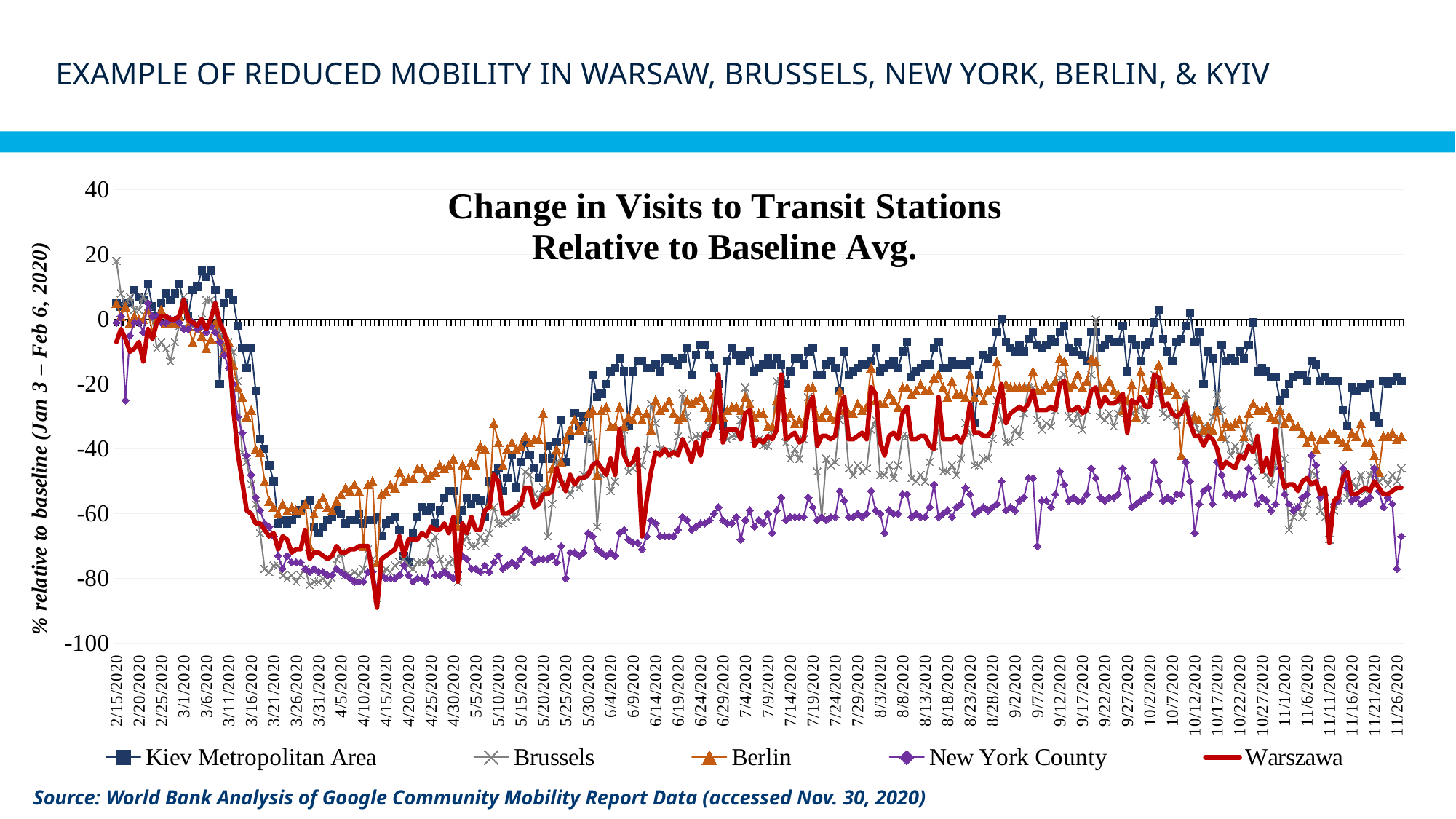
Is the value for New York County on 4/10/2020 greater or less than -60? less What kind of chart is shown on the slide? line chart On 11/26/2020, which is higher: Kiev Metropolitan Area or New York County? Kiev Metropolitan Area Is the value for Warszawa on 4/10/2020 greater or less than -60? less What is the label on the vertical axis of the chart? % relative to baseline (Jan 3 – Feb 6, 2020) How many series does the legend list? 5 Which series has the lowest value around 7/4/2020? New York County Between 3/11/2020 and 3/21/2020, do the values for Warszawa rise or fall? fall Between 4/15/2020 and 6/19/2020, do the values for Berlin rise or fall? rise What is the title of the chart? Change in Visits to Transit Stations Relative to Baseline Avg. Which series has the highest value around 9/2/2020? Kiev Metropolitan Area Is the value for Kiev Metropolitan Area on 3/1/2020 greater or less than 0? greater